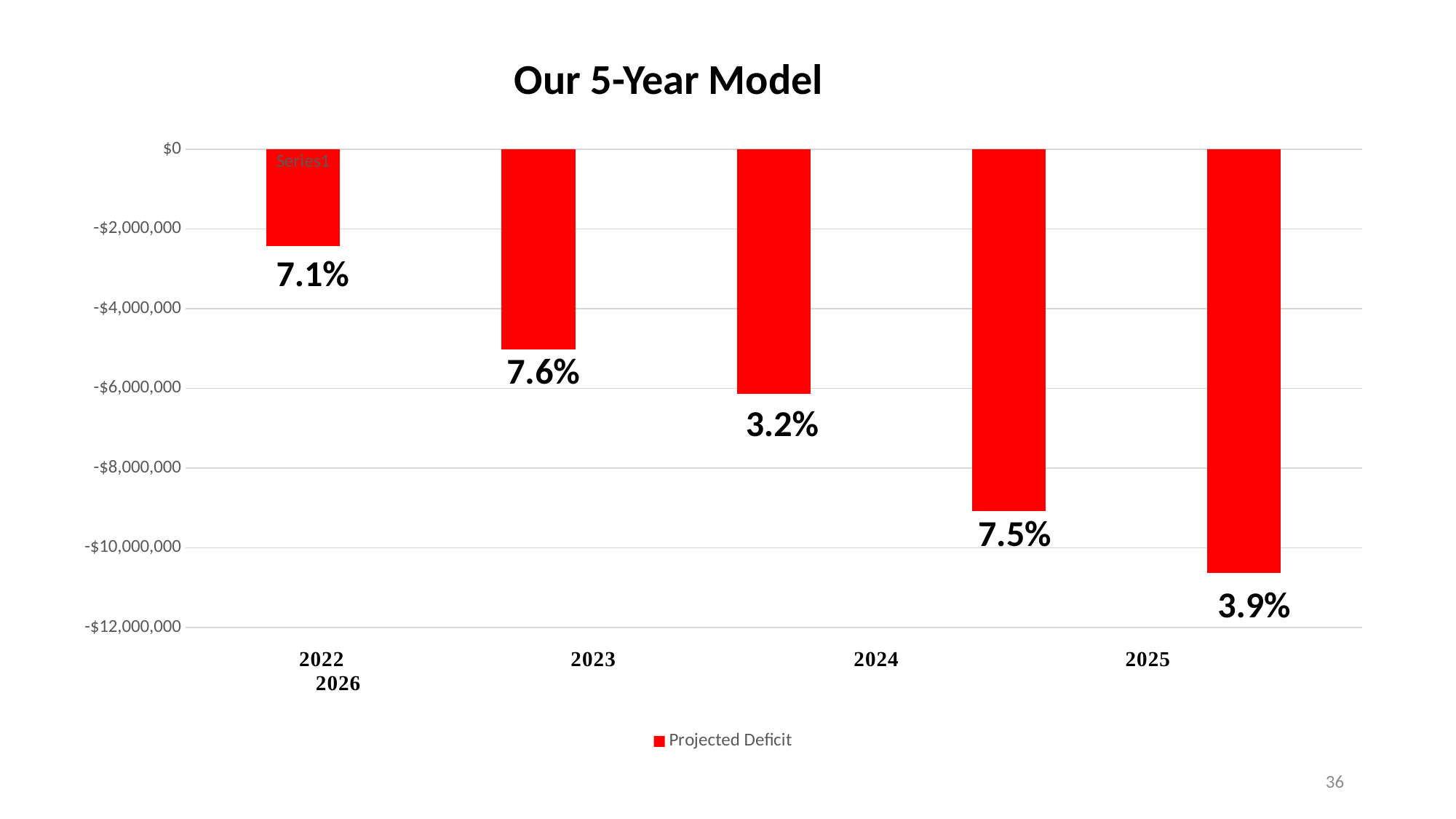
How many bars are plotted in the chart? 5 What series name is shown in the legend? Projected Deficit Do the bars get longer or shorter moving from left to right along the x axis? Longer What percentage label is printed below the rightmost bar? 3.9% What kind of chart is shown on the slide? Bar chart What percentage label is printed below the 2025 bar? 7.5% How many series does the legend list? 1 What percentage label is printed below the 2023 bar? 7.6% What percentage label is printed below the 2024 bar? 3.2% Is the value for 2023 greater or less than -4,000,000? less What is the title of the chart? Our 5-Year Model Which year has the shortest bar (smallest projected deficit)? 2022